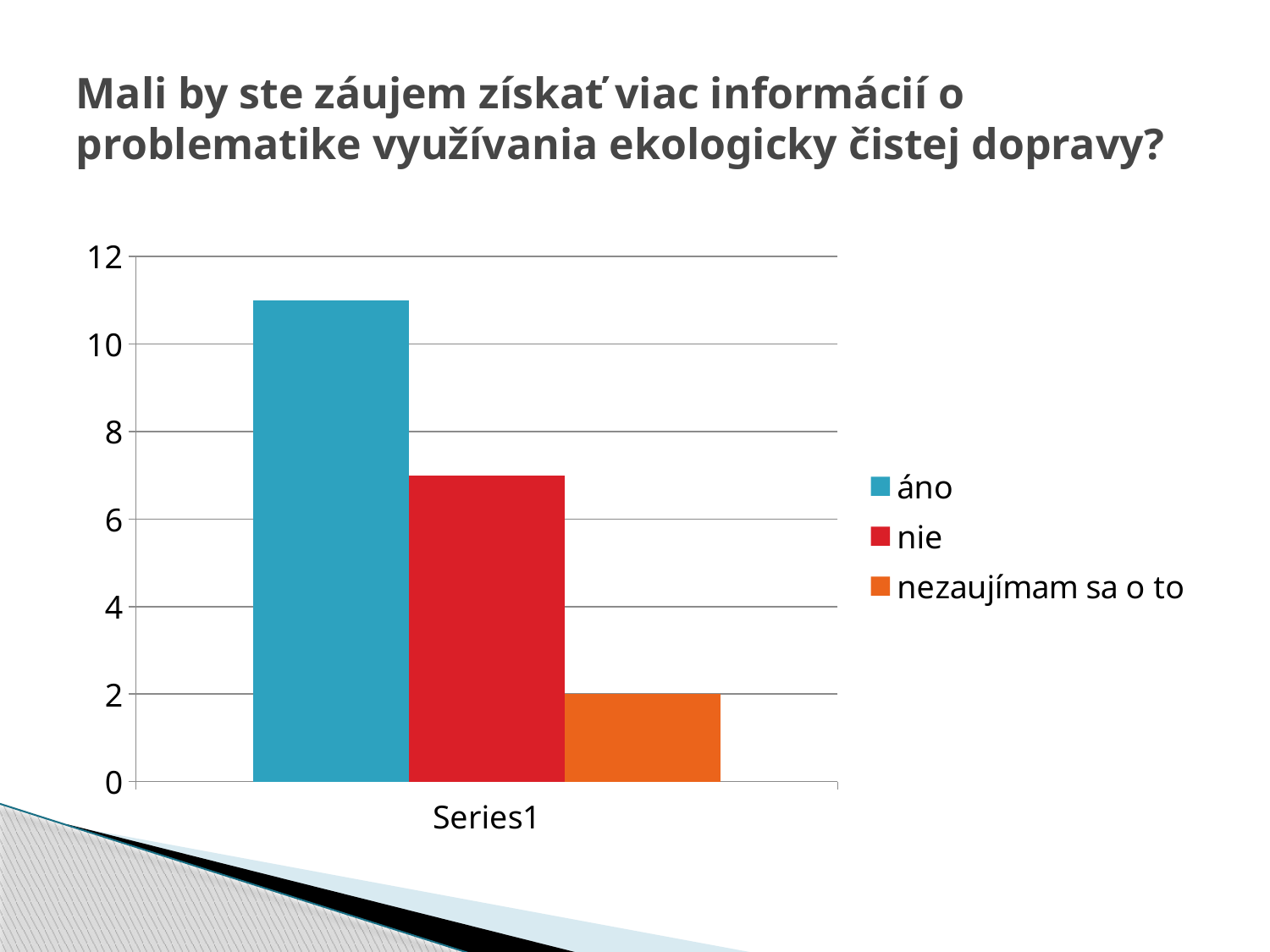
Which response has the highest bar? áno What kind of chart is shown on the slide? bar chart What colour is the bar for "nie"? red Is the value for "nie" greater or less than 8? less What is the value for "nezaujímam sa o to"? 2 Which is larger, the value for "áno" or the value for "nie"? áno Which response has the lowest bar? nezaujímam sa o to Is the value for "nie" greater or less than 6? greater Which is larger, the value for "nie" or the value for "nezaujímam sa o to"? nie How many series does the legend list? 3 What is the highest value shown on the vertical axis? 12 Is the value for "áno" greater or less than 10? greater